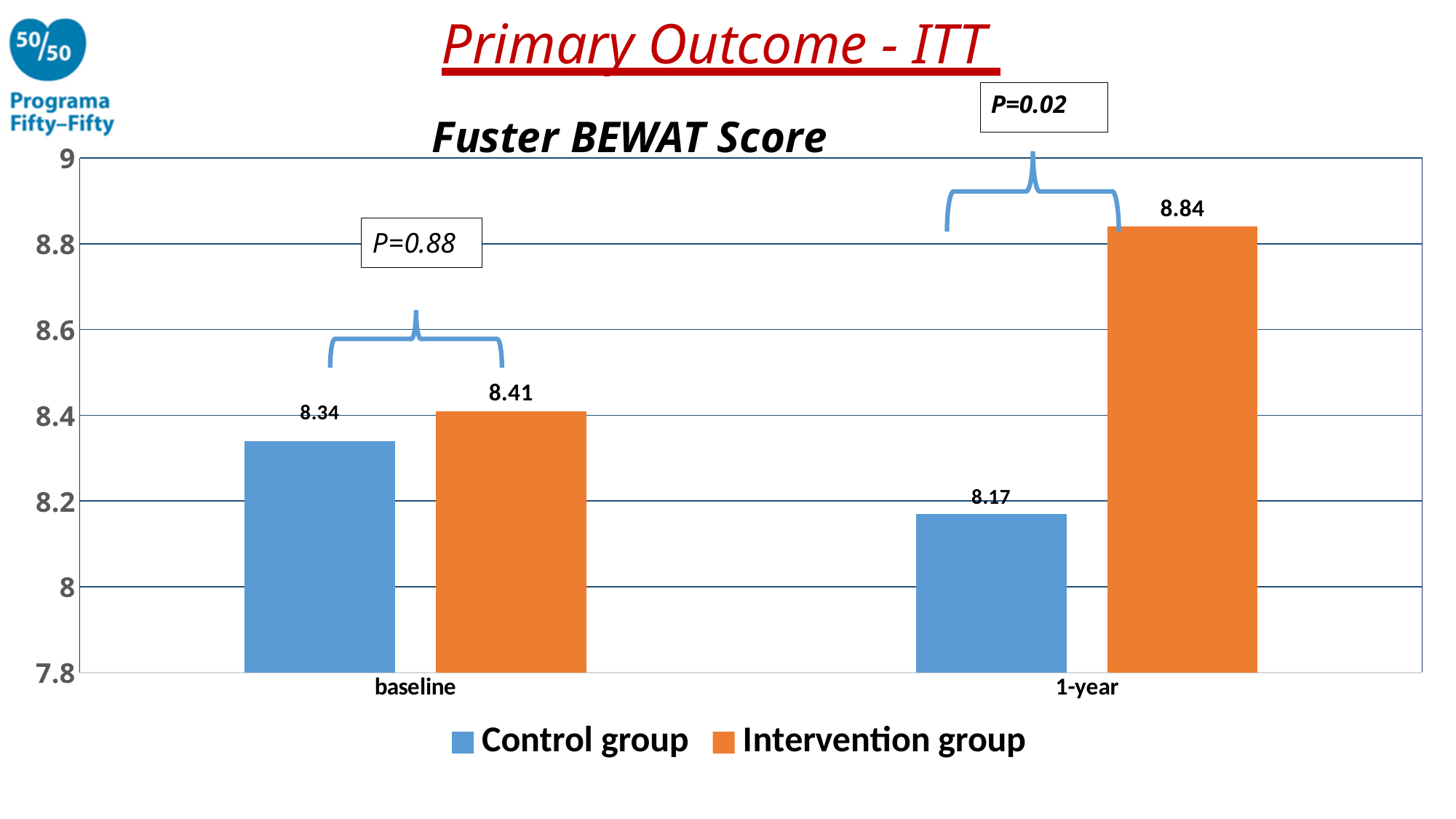
What is the Fuster BEWAT Score for the Intervention group at 1-year? 8.84 Which bar has the lowest Fuster BEWAT Score? Control group at 1-year What is the difference between the Intervention group and Control group scores at 1-year? 0.67 How many series does the legend list? 2 Which bar has the highest Fuster BEWAT Score? Intervention group at 1-year What kind of chart is shown on the slide? Bar chart How many categories are shown on the x axis? 2 At baseline, which group has the higher Fuster BEWAT Score? Intervention group What is the P value shown for the 1-year comparison? P=0.02 What is the Fuster BEWAT Score for the Intervention group at baseline? 8.41 What is the Fuster BEWAT Score for the Control group at baseline? 8.34 What is the Fuster BEWAT Score for the Control group at 1-year? 8.17